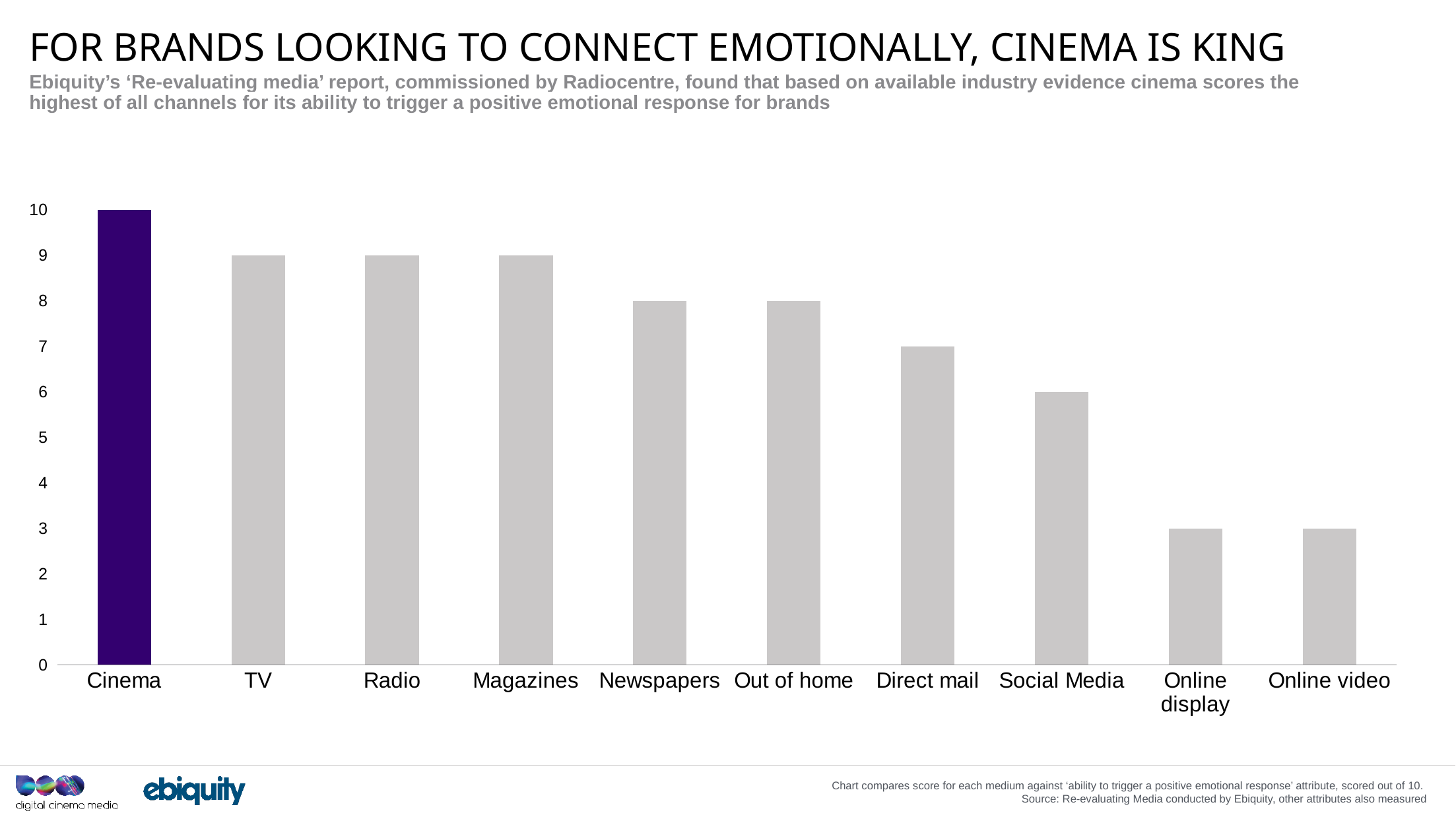
What is the value for Newspapers? 8 What kind of chart is shown on the slide? bar chart Which category has the highest value? Cinema What is the value for Social Media? 6 What is the value for Direct mail? 7 Which bar is coloured differently from the others? Cinema How many categories are shown on the x axis? 10 Which is larger, the value for Magazines or the value for Out of home? Magazines What is the value for Cinema? 10 Is the value for Direct mail greater or less than 5? greater What is the difference between the values for TV and Online display? 6 What is the difference between the values for Cinema and Social Media? 4